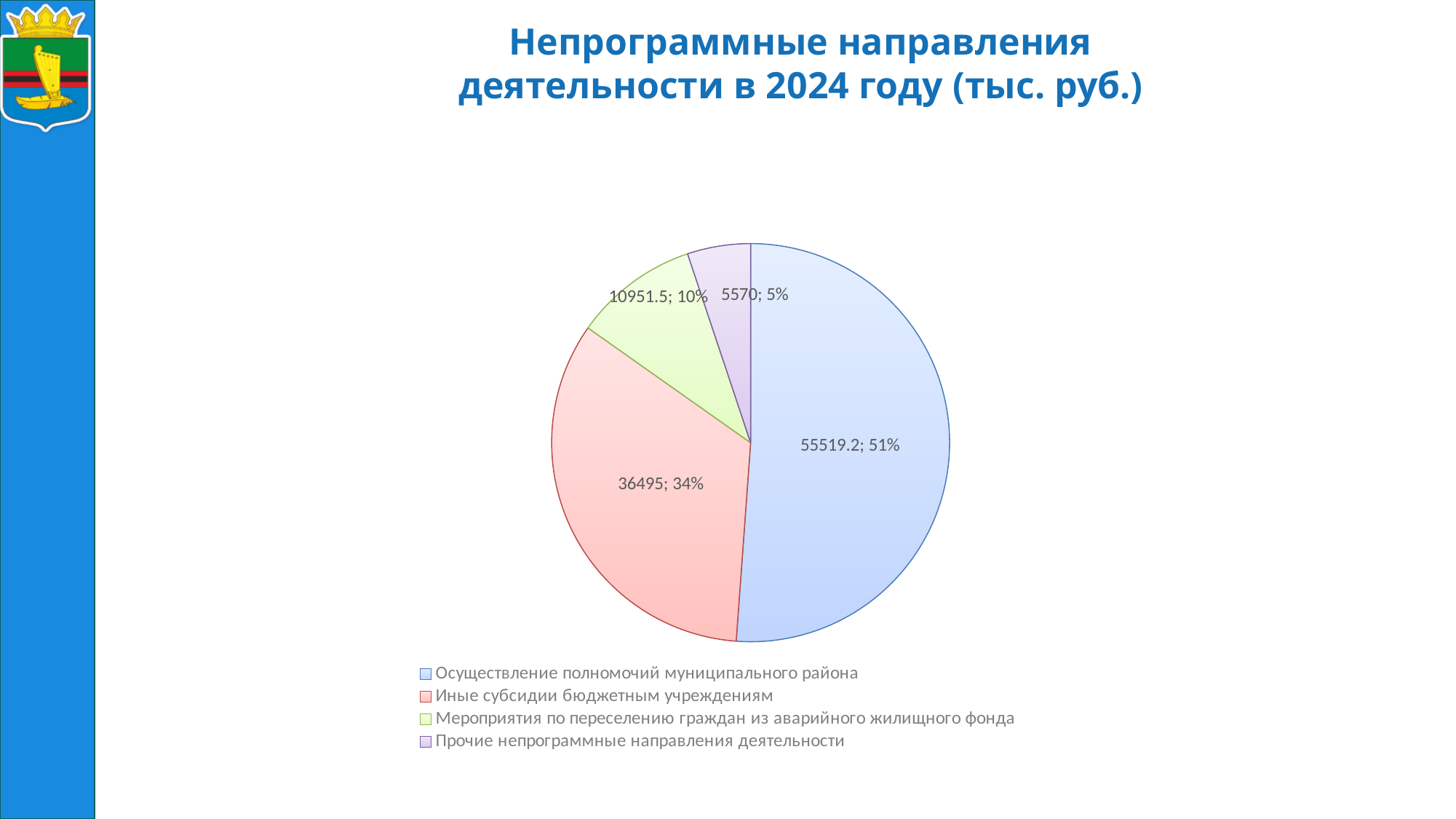
Which category has the smallest slice of the pie? Прочие непрограммные направления деятельности What share of the pie does "Иные субсидии бюджетным учреждениям" represent? 34% What is the difference between the values for "Осуществление полномочий муниципального района" and "Иные субсидии бюджетным учреждениям"? 19024.2 What is the value for "Мероприятия по переселению граждан из аварийного жилищного фонда"? 10951.5 What share of the pie does "Мероприятия по переселению граждан из аварийного жилищного фонда" represent? 10% Which category has the largest slice of the pie? Осуществление полномочий муниципального района What is the value for "Прочие непрограммные направления деятельности"? 5570 What is the value for "Иные субсидии бюджетным учреждениям"? 36495 How many categories does the pie chart have? 4 What type of chart is shown on the slide? Pie chart What is the title of the chart on the slide? Непрограммные направления деятельности в 2024 году (тыс. руб.) What is the value for "Осуществление полномочий муниципального района"? 55519.2